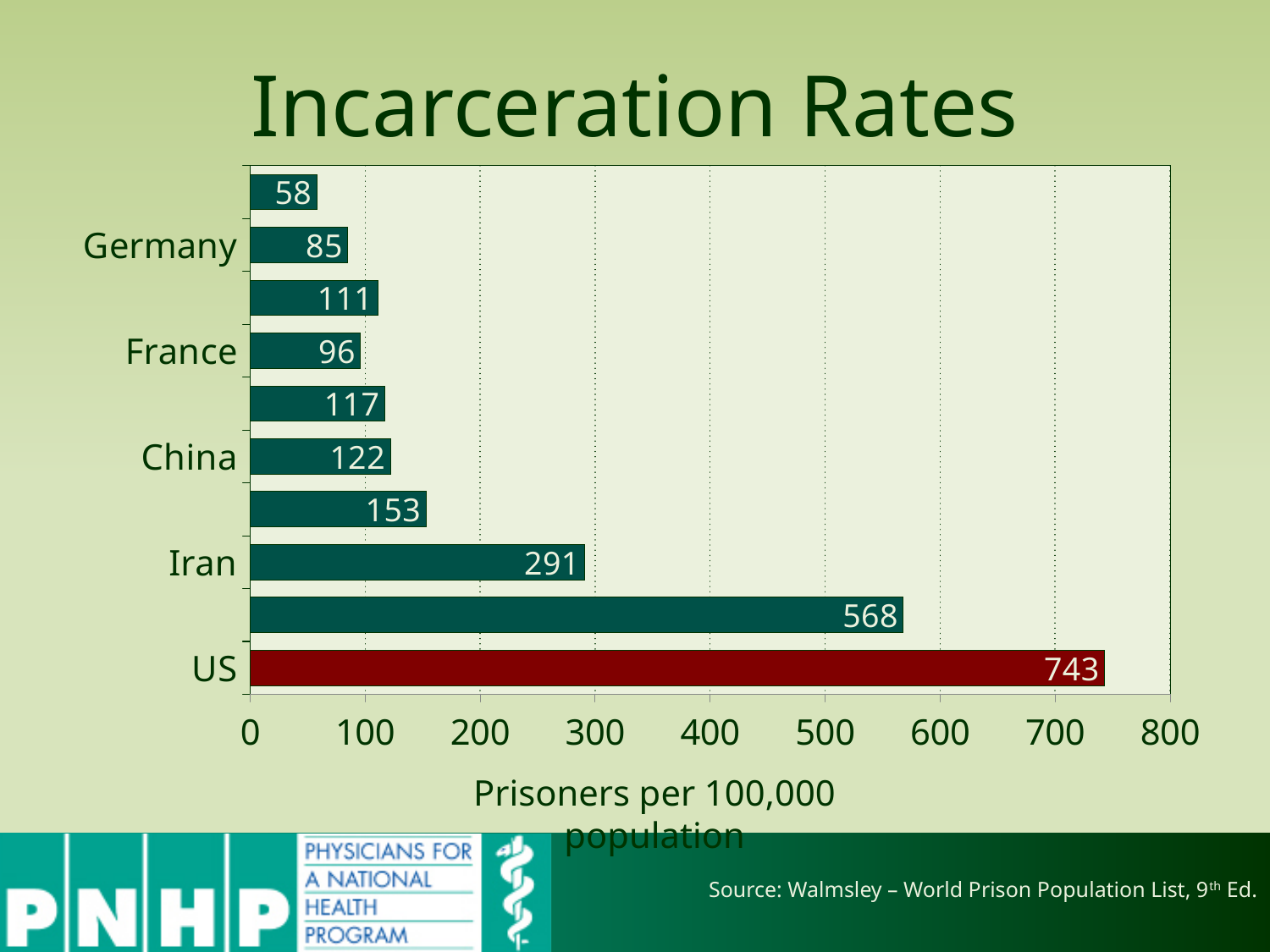
What is the smallest value printed on any bar in the chart? 58 What kind of chart is shown on the slide? Bar chart Which has a higher value, China or France? China What is the value shown for France? 96 Which labelled country has the highest incarceration rate? US What is the value shown for China? 122 What is the value shown for Germany? 85 What is the title of the chart? Incarceration Rates What is the difference between the values for the US and Iran? 452 How many bars are plotted in the chart? 10 What is the value shown for Iran? 291 What is the incarceration rate shown for the US? 743